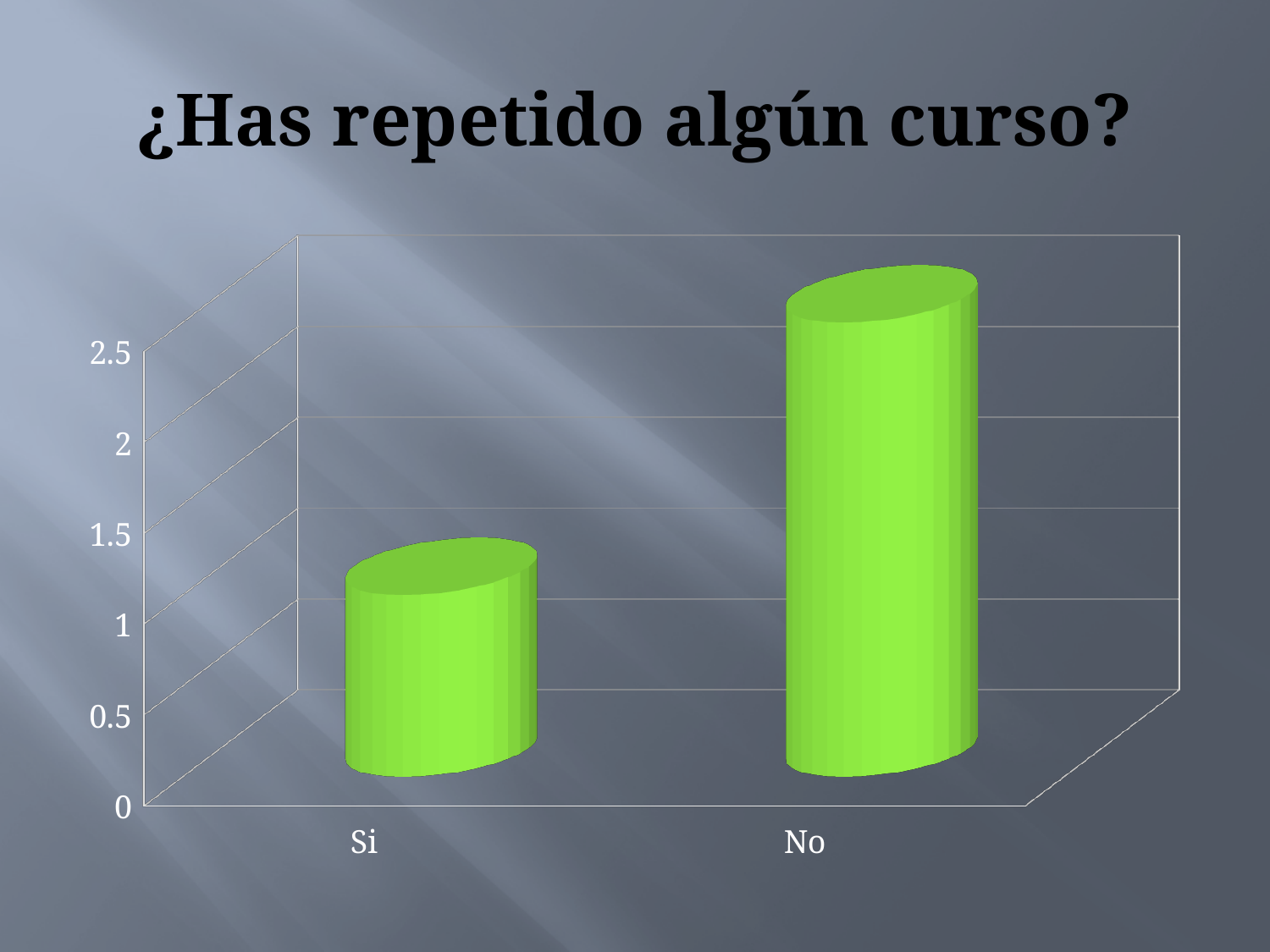
What is the title of the chart? ¿Has repetido algún curso? Which is larger, the value for Si or the value for No? No Do the values rise or fall from Si to No along the x axis? rise Is the value for No greater or less than 2? greater What kind of chart is shown on the slide? bar chart What is the highest tick value shown on the vertical axis? 2.5 Which category has the highest value? No Which category has the lowest value? Si Is the value for Si greater or less than 2? less Is the value for No greater or less than 1.5? greater How many categories are shown on the x axis? 2